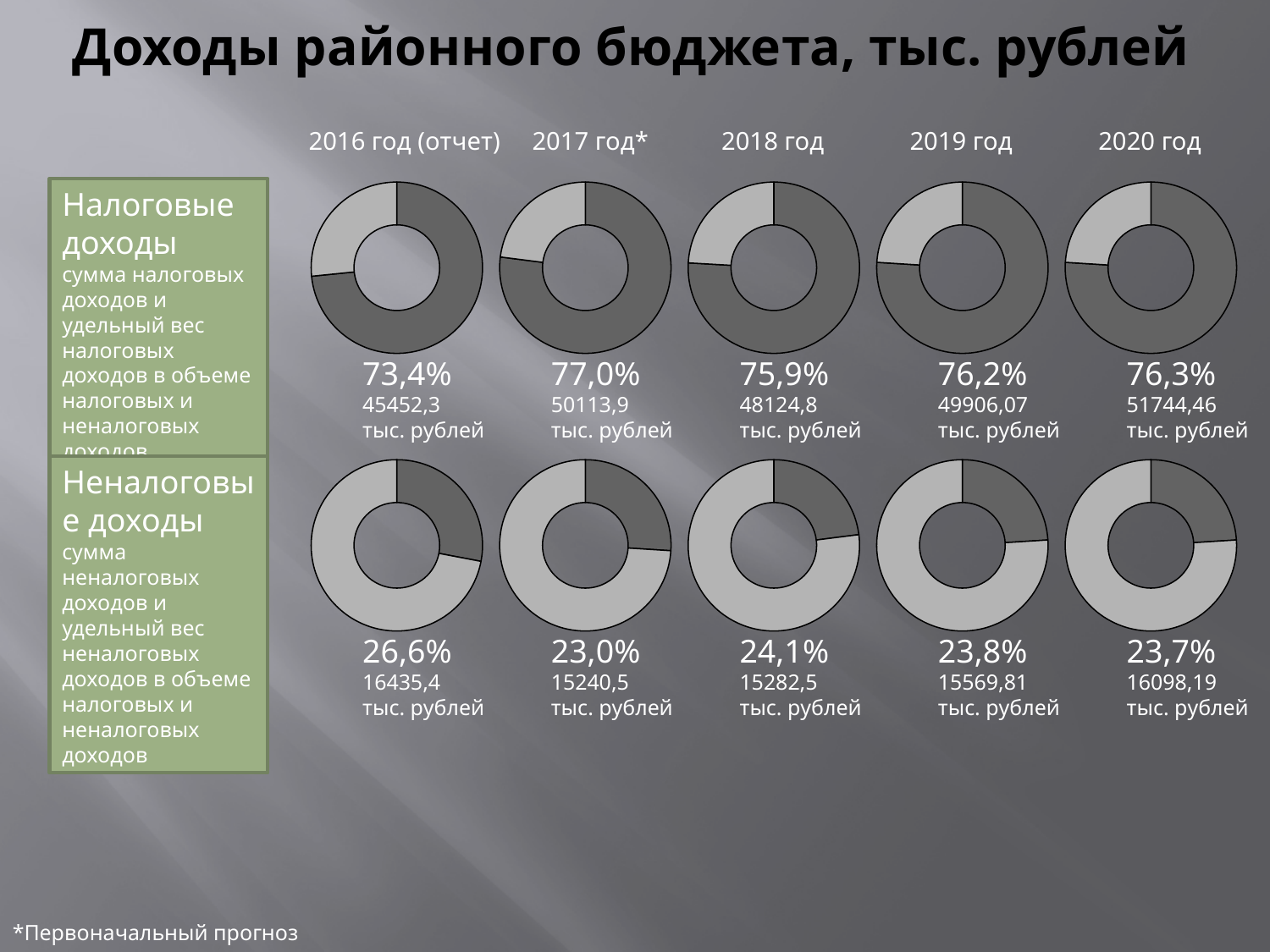
In the 'Налоговые доходы' chart for 2018 год, what is the sum of tax revenues? 48124,8 тыс. рублей In the 'Налоговые доходы' charts, which year has the larger sum of tax revenues: 2019 год or 2020 год? 2020 год In the 'Налоговые доходы' chart for 2017 год*, what share of revenues do tax revenues make up? 77,0% What kind of chart is used to show the revenue shares on this slide? Pie (donut) chart Across the 'Налоговые доходы' charts, which year has the highest share of tax revenues? 2017 год* In the 'Неналоговые доходы' charts, does the share of non-tax revenues rise or fall from 2016 год (отчет) to 2017 год*? Fall What is the combined sum of tax and non-tax revenues for 2016 год (отчет), based on the values printed under the two charts? 61887,7 тыс. рублей What is the title of the slide containing the charts? Доходы районного бюджета, тыс. рублей Across the 'Неналоговые доходы' charts, which year has the lowest share of non-tax revenues? 2017 год* How many donut charts are shown on the slide in total? 10 By how many percentage points is the tax revenue share in 2017 год* higher than in 2016 год (отчет) in the 'Налоговые доходы' charts? 3,6% In the 'Неналоговые доходы' chart for 2020 год, what is the sum of non-tax revenues? 16098,19 тыс. рублей